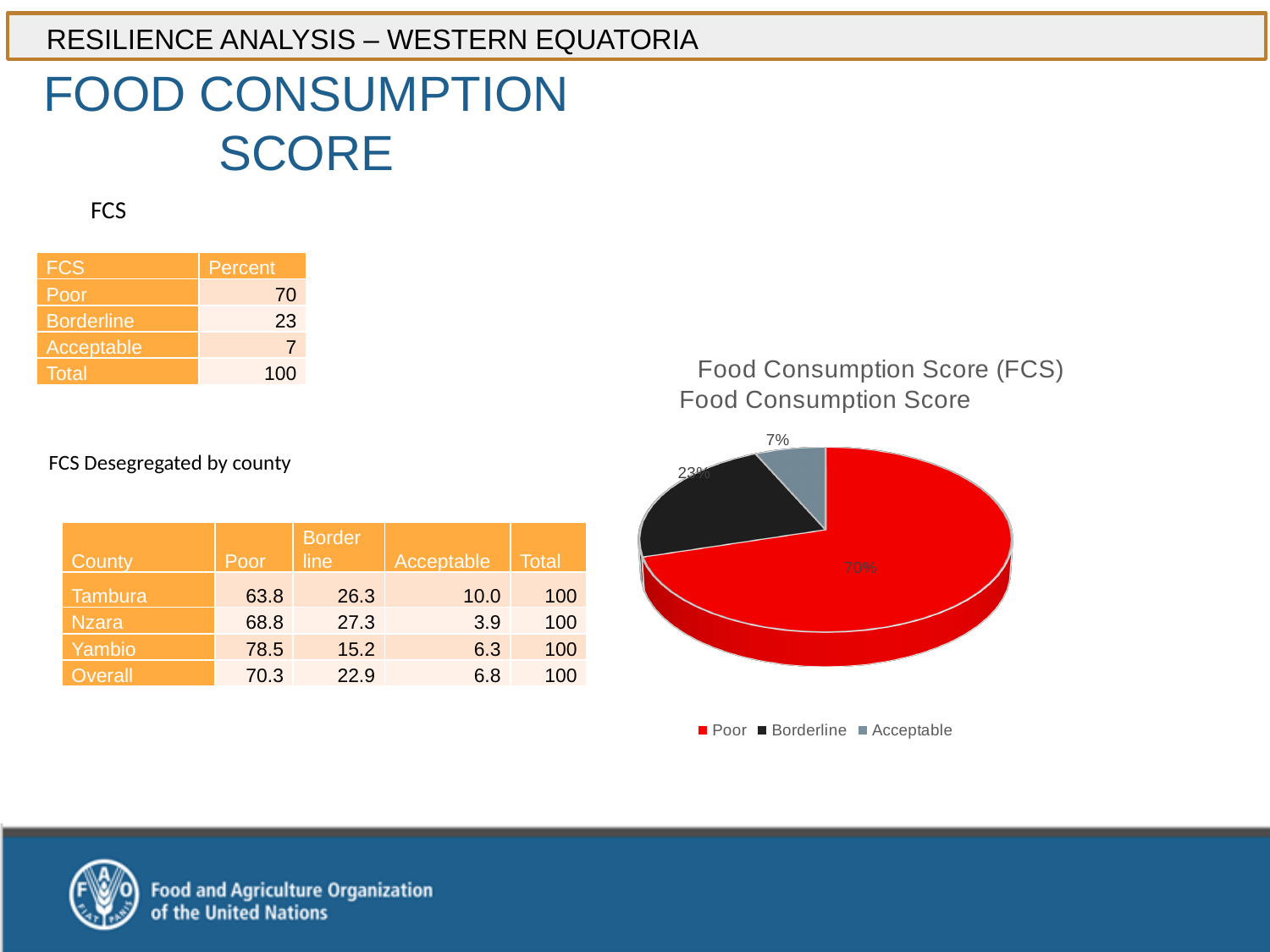
What share of the pie does the Acceptable slice represent? 7% How many entries does the legend list? 3 What share of the pie does the Borderline slice represent? 23% Which category has the largest slice of the pie? Poor What kind of chart is shown on the slide? pie chart Which slice is larger, Borderline or Acceptable? Borderline What share of the pie does the Poor slice represent? 70% Which colour represents the Poor category in the pie chart? red Which category has the smallest slice of the pie? Acceptable What is the difference in percentage points between the Poor and Borderline slices? 47 What is the title of the pie chart? Food Consumption Score How many slices does the pie chart have? 3